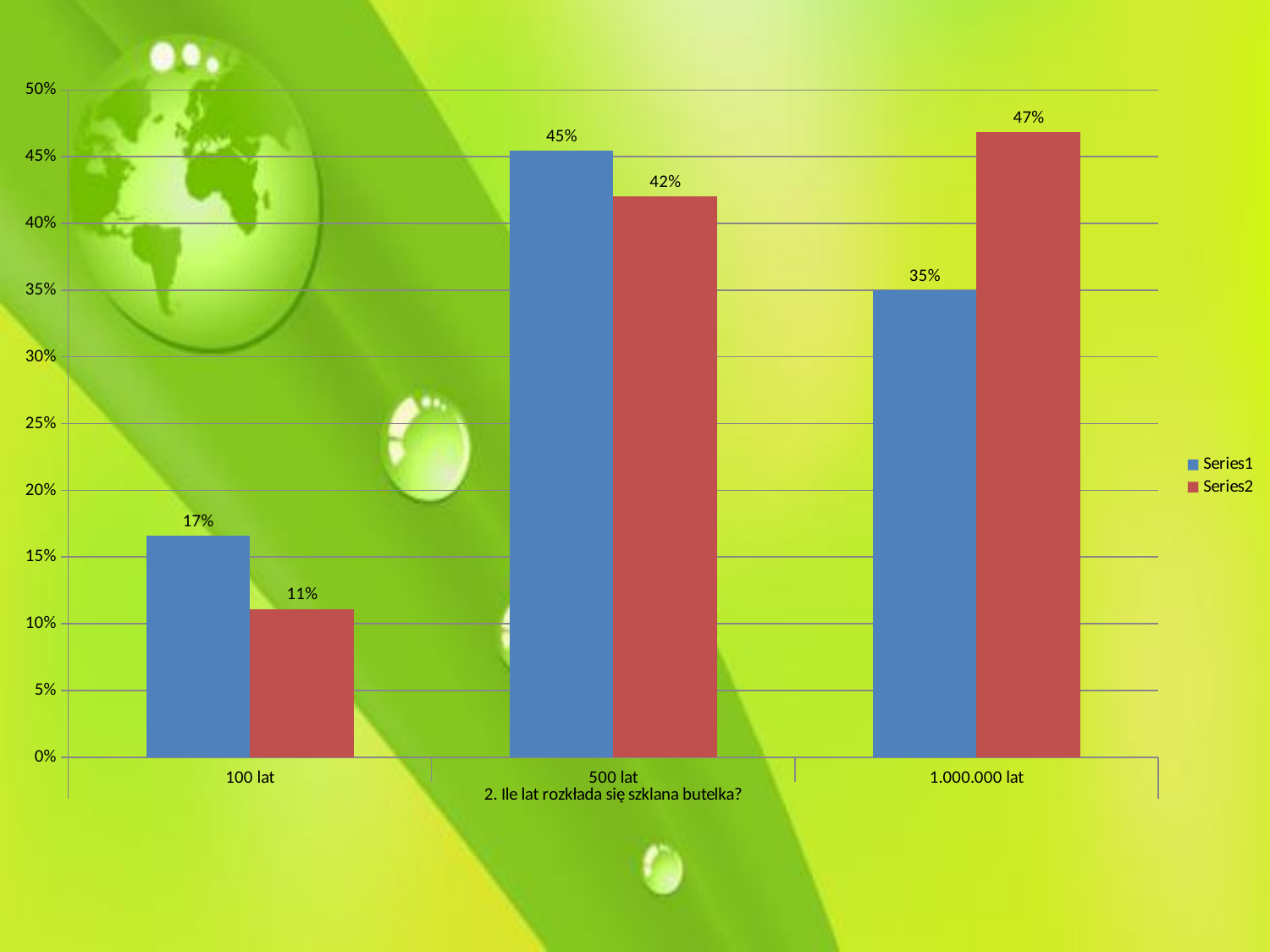
Which category has the lowest Series2 value? 100 lat What is the value of Series2 for the category "100 lat"? 11% What kind of chart is shown on the slide? bar chart What is the value of Series1 for the category "500 lat"? 45% What is the difference between the Series2 values for "1.000.000 lat" and "500 lat"? 5% What is the value of Series2 for the category "1.000.000 lat"? 47% How many series does the legend list? 2 For the category "1.000.000 lat", which series has the larger value, Series1 or Series2? Series2 How many categories are shown on the x axis? 3 Which category has the highest Series1 value? 500 lat What is the x-axis title of the chart? 2. Ile lat rozkłada się szklana butelka? What is the difference between the Series1 and Series2 values for "100 lat"? 6%